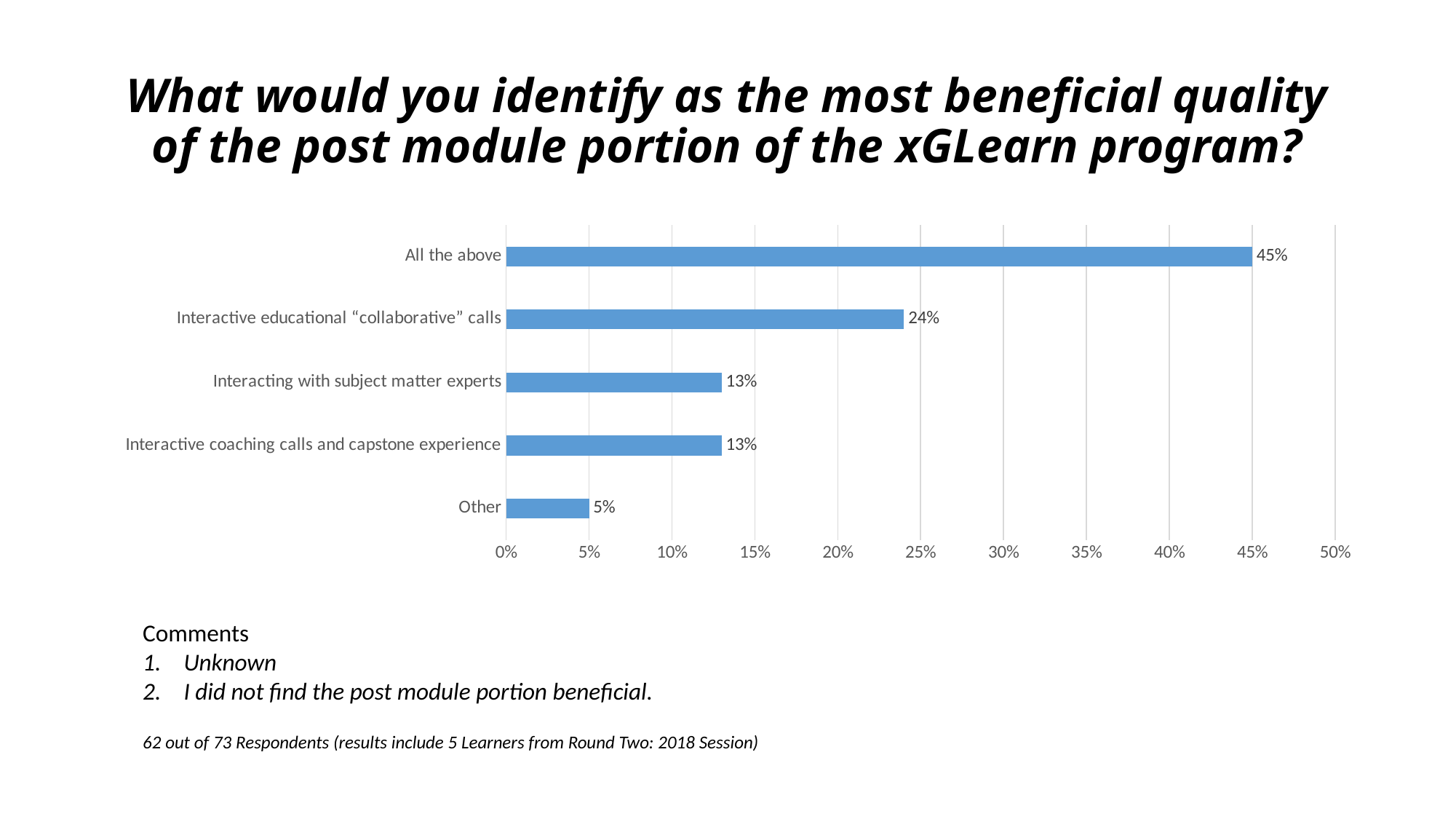
What is the value for "Interactive educational "collaborative" calls"? 24% What percentage of respondents chose "All the above"? 45% What is the value for "Interacting with subject matter experts"? 13% Is the value for "All the above" greater or less than 40%? greater Which is larger, the value for "Interactive educational "collaborative" calls" or the value for "Interactive coaching calls and capstone experience"? Interactive educational "collaborative" calls What is the value for "Other"? 5% Which category has the highest value? All the above What is the difference between the values for "Interacting with subject matter experts" and "Other"? 8% How many categories are shown in the chart? 5 What is the difference between the values for "All the above" and "Interactive educational "collaborative" calls"? 21% What kind of chart is shown on the slide? bar chart Which category has the lowest value? Other